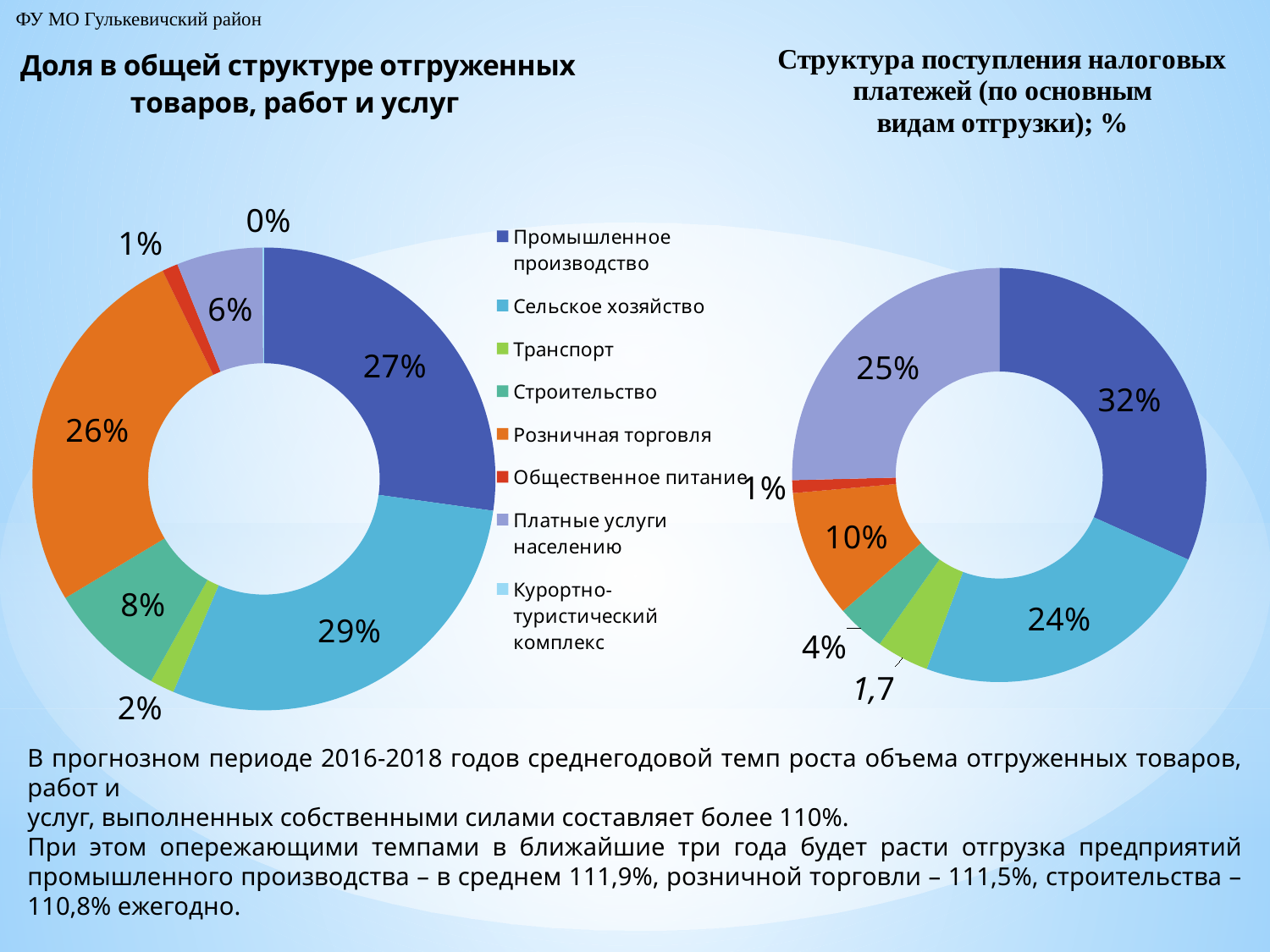
What type of chart is used on the left side of the slide? Doughnut (pie) chart In the chart 'Структура поступления налоговых платежей (по основным видам отгрузки); %', what is the difference between Промышленное производство and Сельское хозяйство? 8% In the chart 'Доля в общей структуре отгруженных товаров, работ и услуг', which category has the largest share? Сельское хозяйство In the chart 'Доля в общей структуре отгруженных товаров, работ и услуг', what is the share for Сельское хозяйство? 29% In the chart 'Доля в общей структуре отгруженных товаров, работ и услуг', what is the share for Розничная торговля? 26% In the chart 'Доля в общей структуре отгруженных товаров, работ и услуг', which category has the smallest share? Курортно-туристический комплекс How many entries does the legend between the two charts list? 8 In the chart 'Структура поступления налоговых платежей (по основным видам отгрузки); %', which is larger: Сельское хозяйство or Розничная торговля? Сельское хозяйство In the chart 'Структура поступления налоговых платежей (по основным видам отгрузки); %', what is the value for Платные услуги населению? 25% In the chart 'Доля в общей структуре отгруженных товаров, работ и услуг', what is the difference between the shares of Строительство and Транспорт? 6% In the chart 'Структура поступления налоговых платежей (по основным видам отгрузки); %', what is the value for Промышленное производство? 32%